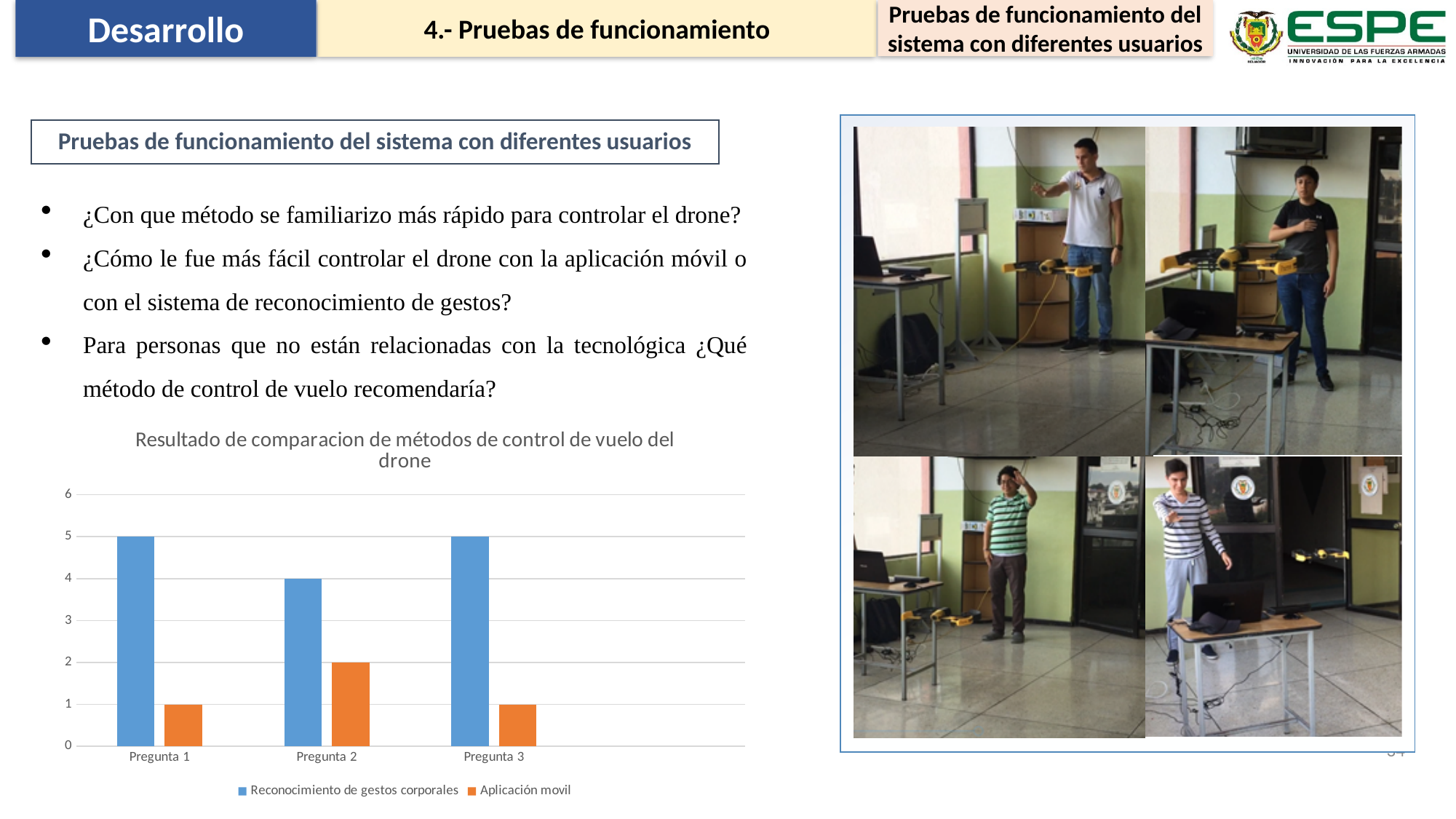
What is the value for Reconocimiento de gestos corporales for Pregunta 1? 5 What kind of chart is shown on the slide? bar chart What is the title of the chart? Resultado de comparacion de métodos de control de vuelo del drone How many categories are shown on the x axis of the chart? 3 How many series does the chart legend list? 2 What is the difference between Reconocimiento de gestos corporales and Aplicación movil for Pregunta 3? 4 Which colour represents the Aplicación movil series in the chart? orange For which question is the Reconocimiento de gestos corporales value lowest? Pregunta 2 For Pregunta 1, which series has the larger value, Reconocimiento de gestos corporales or Aplicación movil? Reconocimiento de gestos corporales For which question does Aplicación movil reach its highest value? Pregunta 2 What is the value for Reconocimiento de gestos corporales for Pregunta 2? 4 What is the value for Aplicación movil for Pregunta 2? 2